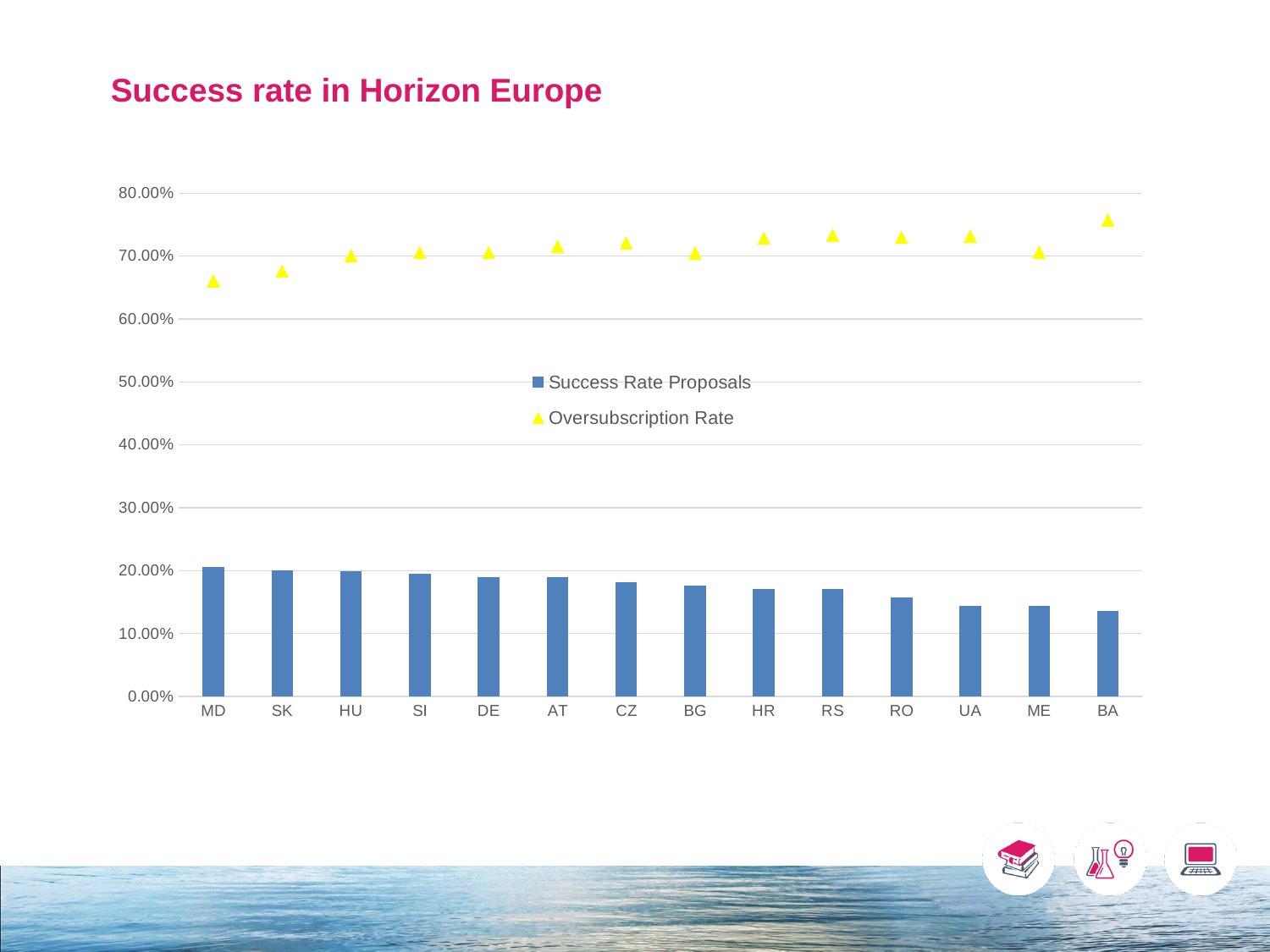
What kind of chart is shown on the slide? A bar chart combined with a scatter/marker series Which country has the highest Oversubscription Rate? BA Is the Success Rate Proposals value for BA greater or less than 20.00%? less Is the Oversubscription Rate for BA greater or less than 70.00%? greater How many countries are shown on the x axis of the chart? 14 Which country has the lowest Success Rate Proposals value? BA How many series does the legend list? 2 Which country has the highest Success Rate Proposals value? MD Do the Success Rate Proposals bars rise or fall from left to right across the x axis? fall Which has the larger Success Rate Proposals value, SK or ME? SK Which country has the lowest Oversubscription Rate? MD Is the Oversubscription Rate for MD greater or less than 70.00%? less